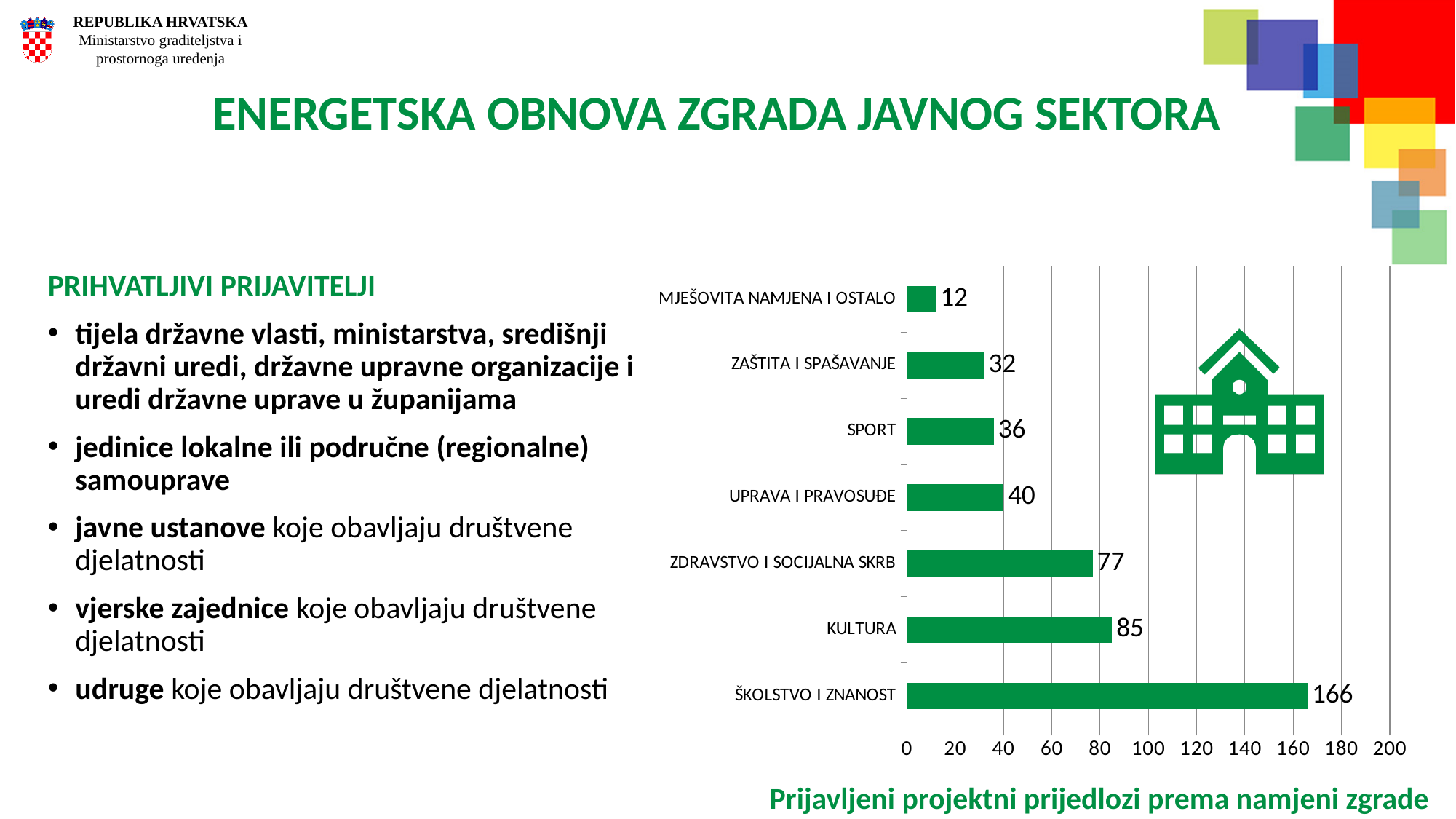
How many categories are shown in the chart? 7 Which is larger, the value for SPORT or the value for UPRAVA I PRAVOSUĐE? UPRAVA I PRAVOSUĐE What is the value for ŠKOLSTVO I ZNANOST? 166 What kind of chart is shown on the slide? bar chart What is the title of the chart? Prijavljeni projektni prijedlozi prema namjeni zgrade What is the value for ZDRAVSTVO I SOCIJALNA SKRB? 77 Is the value for KULTURA greater or less than 100? less Which category has the lowest value? MJEŠOVITA NAMJENA I OSTALO What is the difference between the values for KULTURA and ZDRAVSTVO I SOCIJALNA SKRB? 8 Which category has the highest value? ŠKOLSTVO I ZNANOST What is the value for MJEŠOVITA NAMJENA I OSTALO? 12 What is the difference between the values for ŠKOLSTVO I ZNANOST and KULTURA? 81